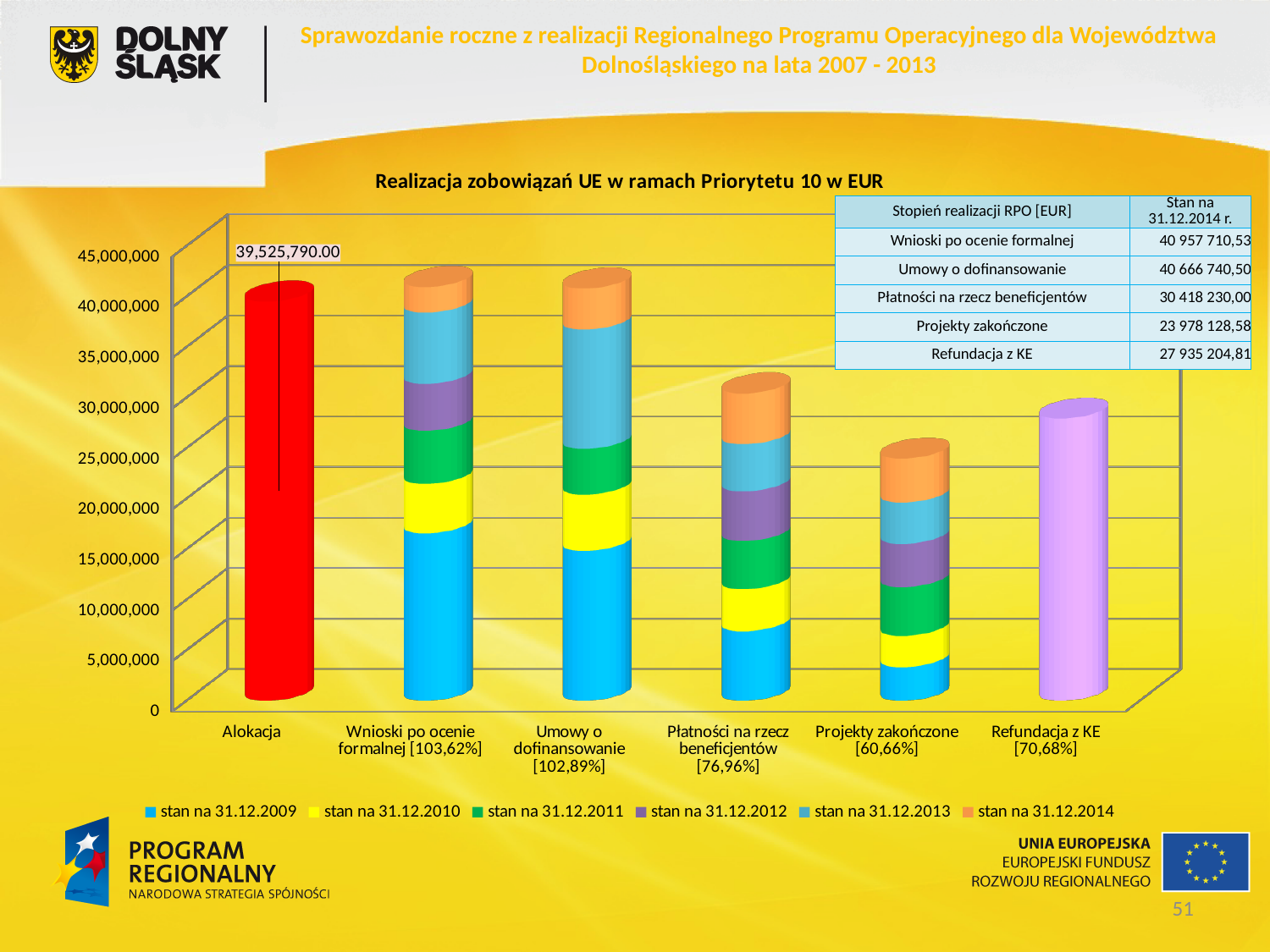
How many series does the chart legend list? 6 According to the table on the chart, what is the value for Projekty zakończone as of 31.12.2014? 23 978 128,58 According to the table on the chart, what is the value for Refundacja z KE as of 31.12.2014? 27 935 204,81 Is the value for Płatności na rzecz beneficjentów greater or less than 35,000,000? less What kind of chart is shown on the slide? bar chart What is the title of the chart? Realizacja zobowiązań UE w ramach Priorytetu 10 w EUR Which bar is taller: Refundacja z KE or Projekty zakończone? Refundacja z KE How many categories are shown on the x axis of the chart? 6 What value is labelled on the Alokacja bar? 39,525,790.00 Which category has the lowest bar in the chart? Projekty zakończone Is the value for Refundacja z KE greater or less than 25,000,000? greater What percentage is shown in the x-axis label for Umowy o dofinansowanie? 102,89%